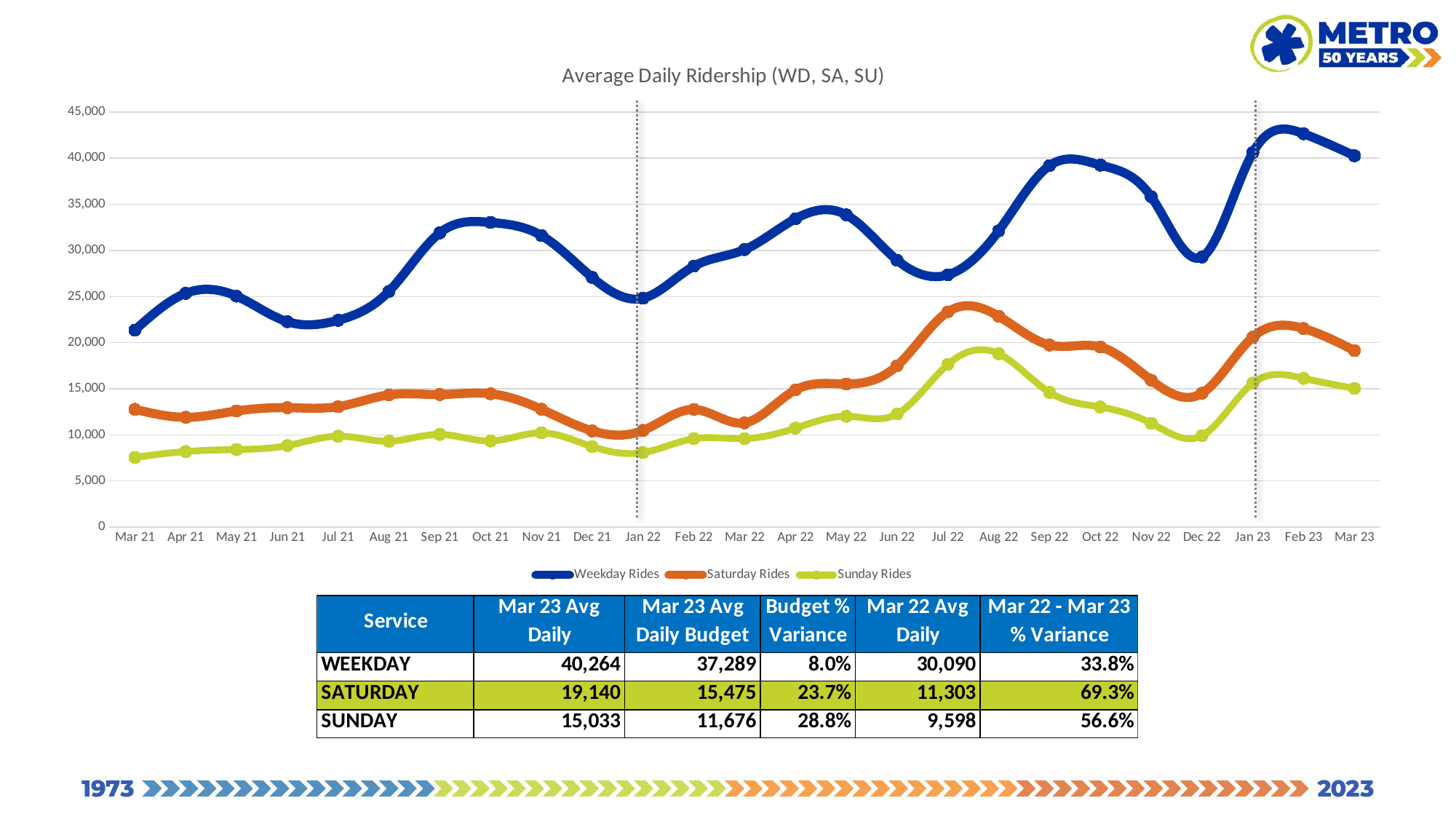
Is the value for Sunday Rides in Jul 22 greater or less than 15,000? greater What type of chart is shown on the slide? line chart Which series has the highest values across the whole chart? Weekday Rides According to the table below the chart, what is the Mar 23 average daily ridership for Weekday? 40,264 Is the value for Weekday Rides in Dec 22 greater or less than 35,000? less How many series does the legend of the chart list? 3 Which is larger for Weekday Rides: the value in Feb 23 or the value in Mar 21? Feb 23 In which month do Weekday Rides reach their highest point on the chart? Feb 23 Is the value for Weekday Rides in Oct 21 greater or less than 30,000? greater How many months are plotted along the x axis of the chart? 25 Using the table values, what is the difference between the Mar 23 average daily ridership for Weekday and for Saturday? 21,124